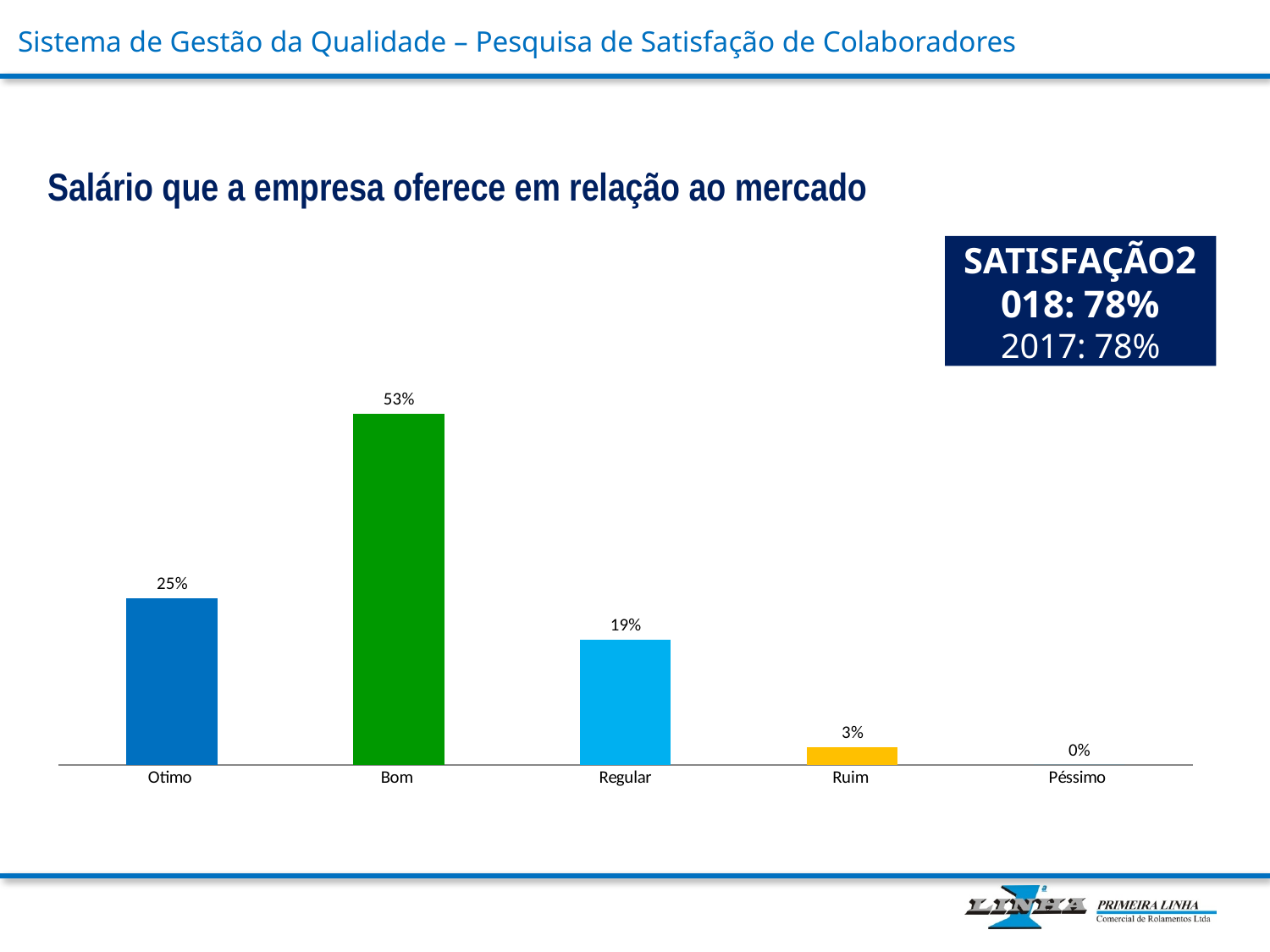
What is the value for Ruim? 3% What kind of chart is shown on the slide? Bar chart What is the value for Péssimo? 0% What is the title of the chart on the slide? Salário que a empresa oferece em relação ao mercado Which category has the lowest value? Péssimo How many categories are shown on the x axis? 5 What is the value for Otimo? 25% What is the value for Regular? 19% Which category has the highest value? Bom What is the difference between the values for Bom and Otimo? 28% What is the value for Bom? 53% Which is larger, the value for Otimo or the value for Regular? Otimo